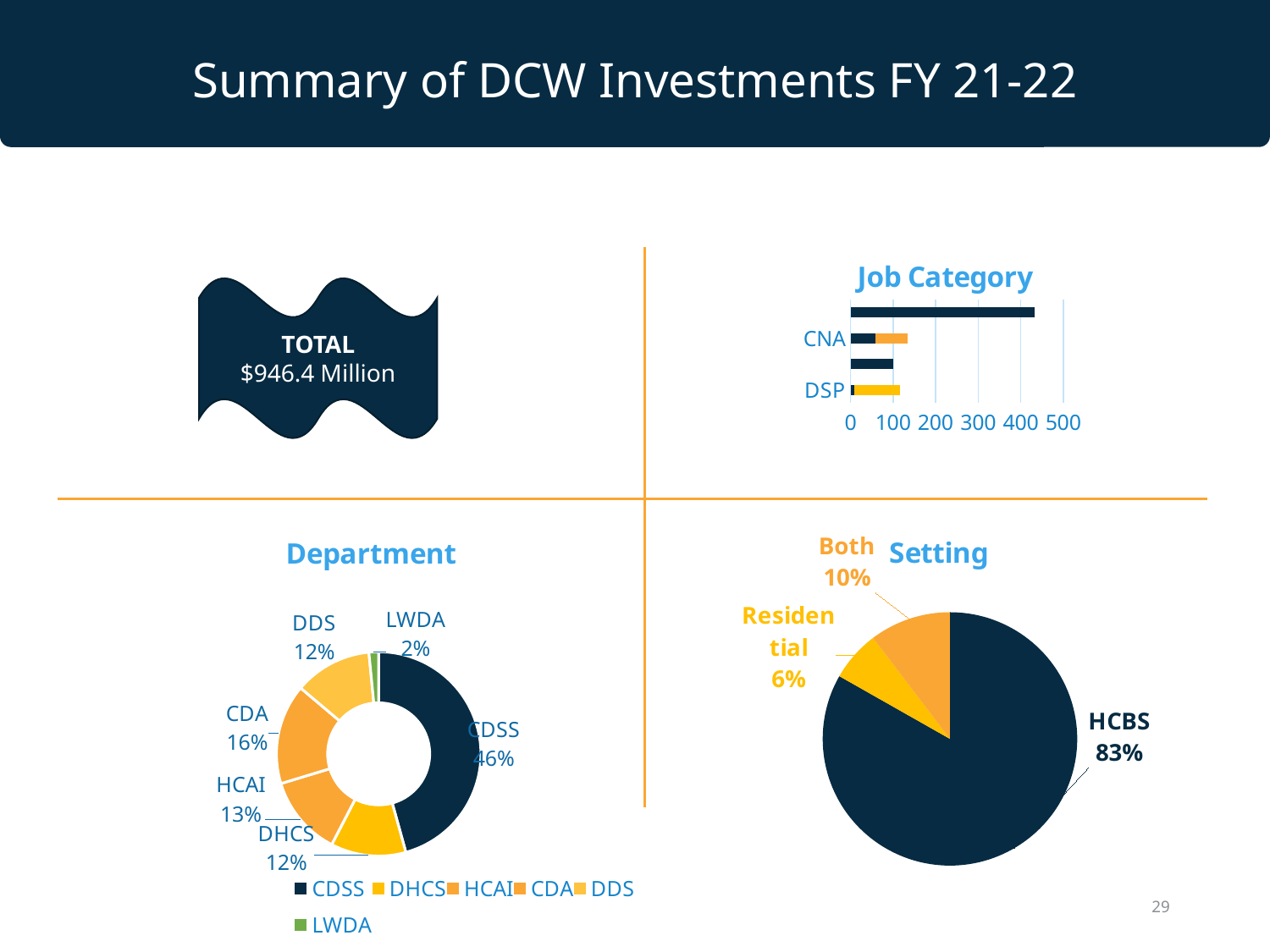
In the Department chart, which department has the smallest share? LWDA In the Setting chart, what percentage is HCBS? 83% In the Setting chart, how many slices are there? 3 What kind of chart is the Job Category chart? bar chart In the Department chart, what percentage is CDA? 16% In the Department chart, what percentage is CDSS? 46% In the Department chart, which department has the largest share? CDSS In the Job Category chart, is the value for CNA greater or less than 300? less In the Department chart, how many departments are shown? 6 In the Department chart, what is the difference in percentage points between CDSS and CDA? 30 In the Setting chart, what percentage is Residential? 6% In the Setting chart, which is larger, Both or Residential? Both